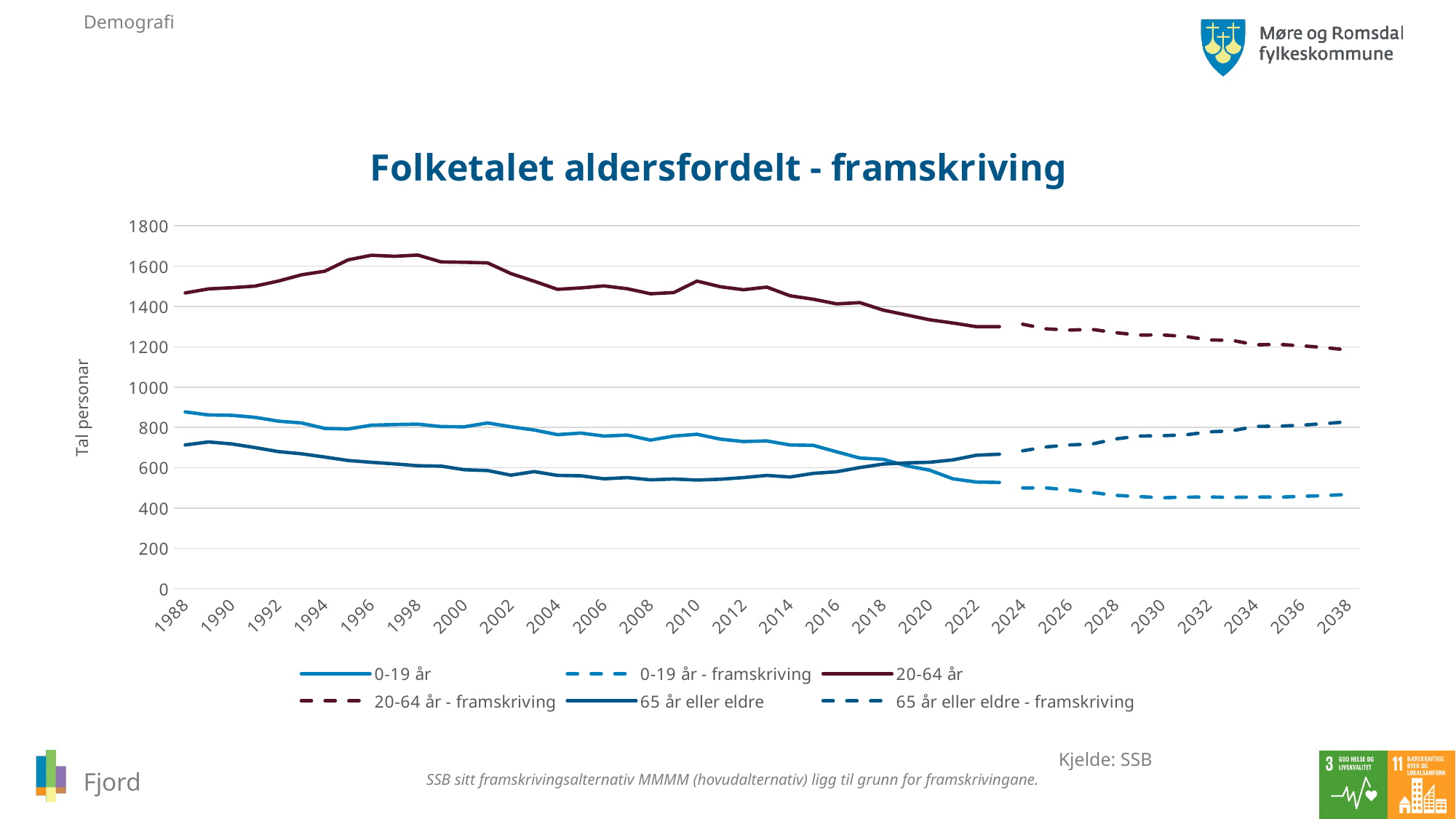
Is the value for 0-19 år in 1988 greater or less than 800? greater Is the value for 20-64 år - framskriving in 2038 greater or less than 1400? less What is the label on the vertical axis? Tal personar Does the 20-64 år - framskriving line rise or fall from 2024 to 2038? fall Is the value for 65 år eller eldre in 2006 greater or less than 600? less What is the title of the chart? Folketalet aldersfordelt - framskriving In 2038, which projected series is larger: 65 år eller eldre - framskriving or 0-19 år - framskriving? 65 år eller eldre - framskriving Which series has the highest values across the whole chart? 20-64 år How many series does the legend list? 6 What kind of chart is shown on the slide? line chart In 1988, which is larger: 0-19 år or 65 år eller eldre? 0-19 år